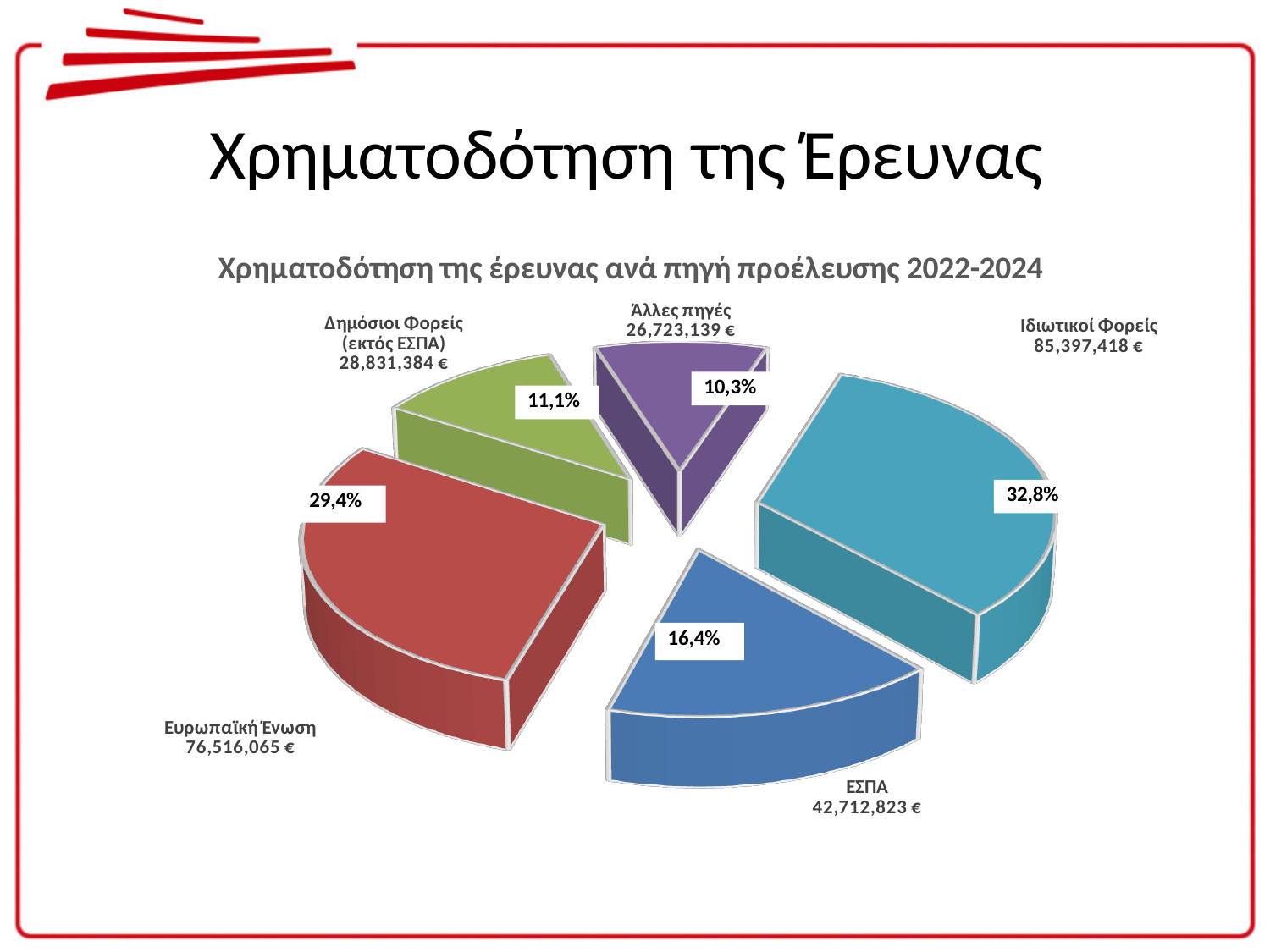
What share of the pie does Δημόσιοι Φορείς (εκτός ΕΣΠΑ) represent? 11,1% Which funding source has the smallest share? Άλλες πηγές What share of the pie does Ευρωπαϊκή Ένωση represent? 29,4% Which funding source has the largest share? Ιδιωτικοί Φορείς What is the funding amount for Άλλες πηγές? 26,723,139 € What is the difference in funding between Ιδιωτικοί Φορείς and Ευρωπαϊκή Ένωση? 8,881,353 € What kind of chart is shown on the slide? Pie chart Which is larger, the funding from ΕΣΠΑ or from Δημόσιοι Φορείς (εκτός ΕΣΠΑ)? ΕΣΠΑ What is the funding amount for ΕΣΠΑ? 42,712,823 € How many slices does the pie chart have? 5 What is the title of the chart? Χρηματοδότηση της έρευνας ανά πηγή προέλευσης 2022-2024 What is the funding amount for Ιδιωτικοί Φορείς? 85,397,418 €